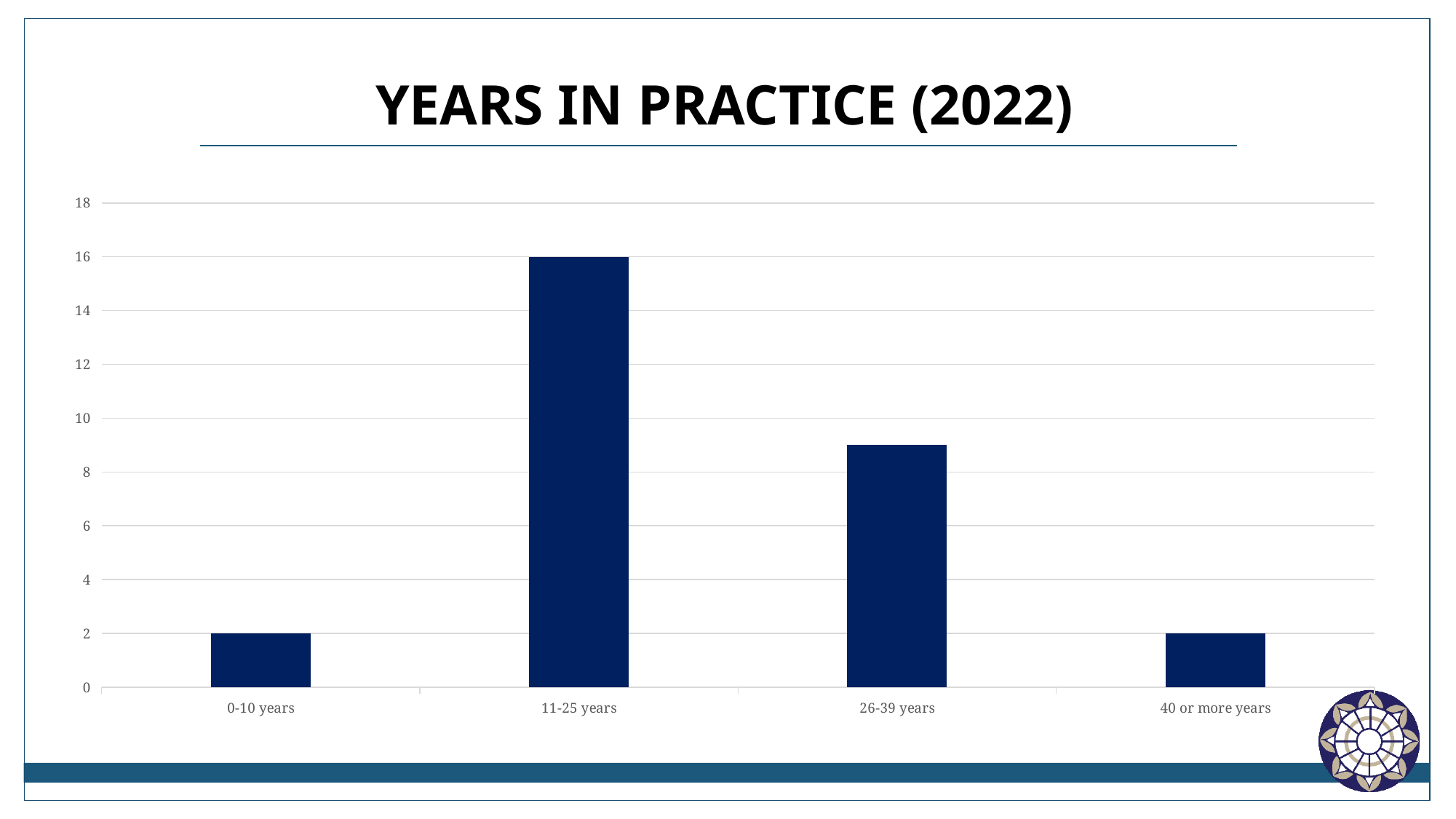
How many categories are shown on the x axis? 4 What is the value for 0-10 years? 2 Which category has the highest value? 11-25 years What is the value for 40 or more years? 2 What is the difference between the values for 11-25 years and 0-10 years? 14 What is the title of the chart? YEARS IN PRACTICE (2022) Is the value for 26-39 years greater or less than 8? greater Is the value for 26-39 years greater or less than 10? less What is the value for 11-25 years? 16 Which is larger, the value for 26-39 years or the value for 40 or more years? 26-39 years What kind of chart is shown on the slide? bar chart Which is larger, the value for 11-25 years or the value for 26-39 years? 11-25 years